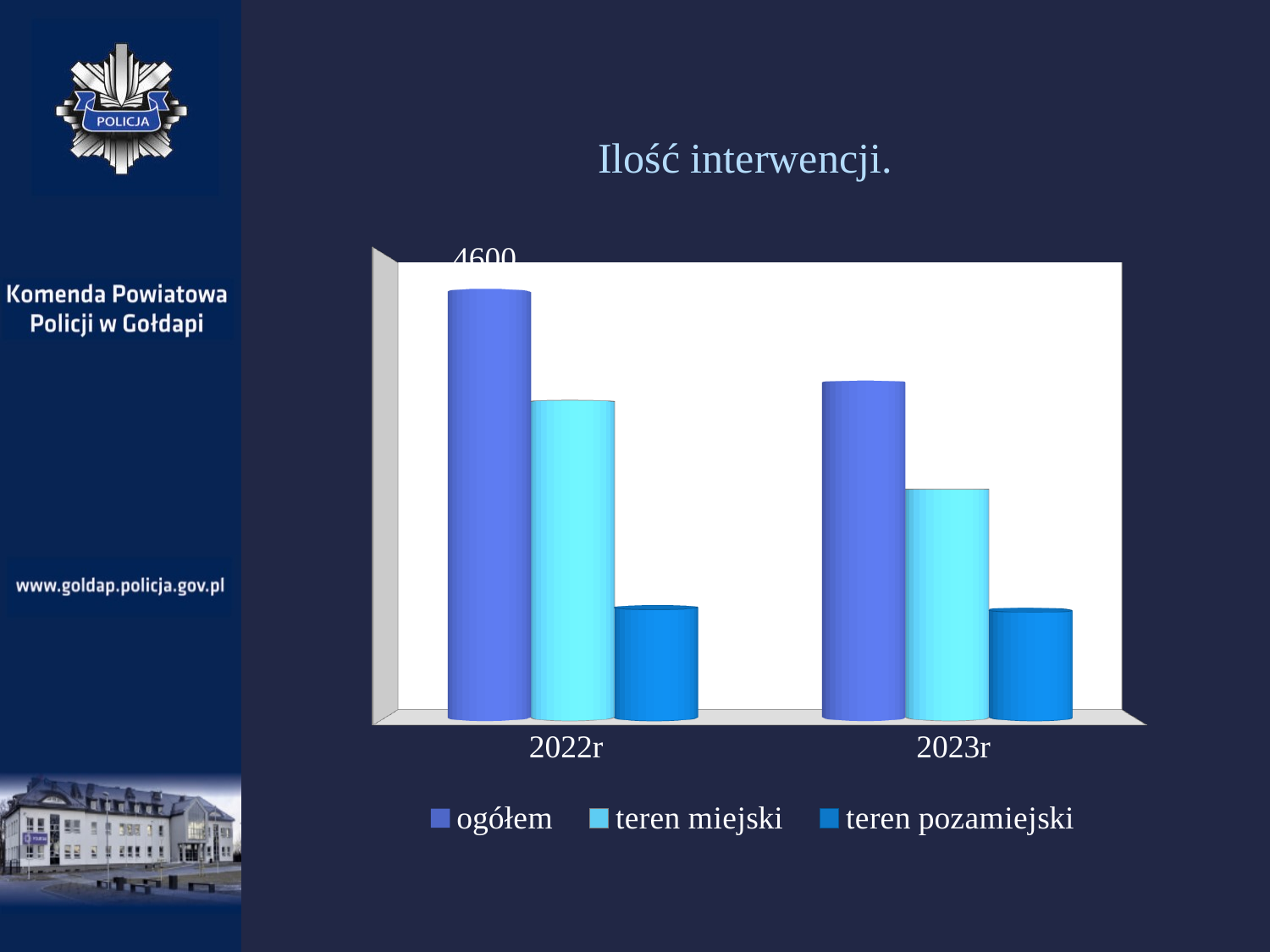
Which series has the highest value for 2022r? ogółem What is the title of the chart? Ilość interwencji. How many series does the legend list? 3 Which series has the lowest value for 2022r? teren pozamiejski Which series has the lowest value for 2023r? teren pozamiejski What kind of chart is shown on the slide? bar chart Is the teren miejski value larger for 2022r or 2023r? 2022r How many categories are shown on the x axis? 2 Does the ogółem series rise or fall from 2022r to 2023r? fall Is the ogółem value larger for 2022r or 2023r? 2022r What is the value of ogółem for 2022r? 4600 Which series are listed in the legend? ogółem, teren miejski, teren pozamiejski